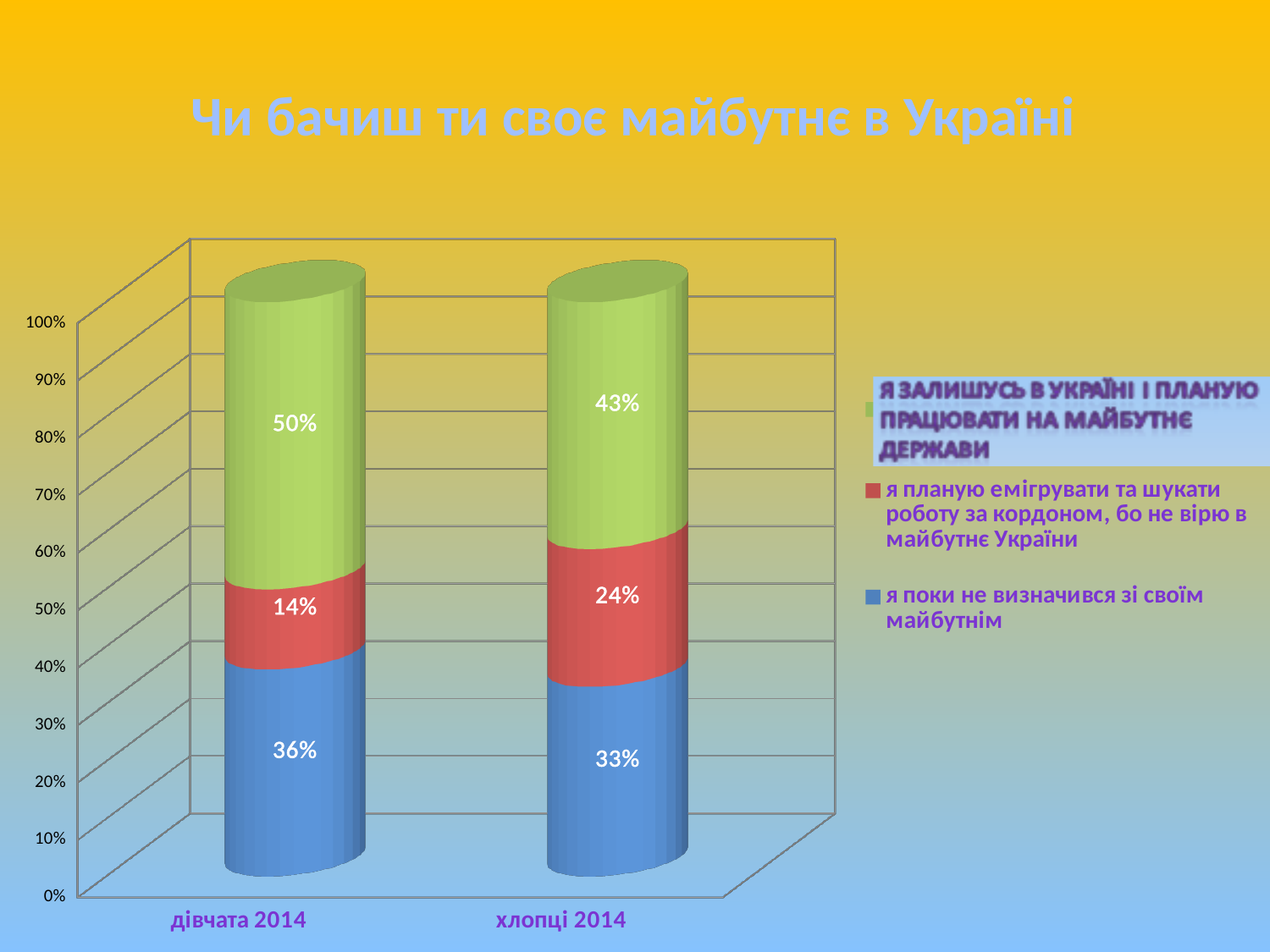
Which group has the larger share for "я залишусь в Україні і планую працювати на майбутнє держави", дівчата 2014 or хлопці 2014? дівчата 2014 Which response has the smallest share among дівчата 2014? я планую емігрувати та шукати роботу за кордоном, бо не вірю в майбутнє України How many series does the chart's legend list? 3 What percentage of хлопці 2014 chose "я поки не визначився зі своїм майбутнім"? 33% What is the difference between the "я планую емігрувати" share for хлопці 2014 and for дівчата 2014? 10% What percentage of дівчата 2014 chose "я планую емігрувати та шукати роботу за кордоном, бо не вірю в майбутнє України"? 14% What percentage of хлопці 2014 chose "я планую емігрувати та шукати роботу за кордоном, бо не вірю в майбутнє України"? 24% How many categories are shown on the x axis of the chart? 2 What percentage of дівчата 2014 chose "я залишусь в Україні і планую працювати на майбутнє держави"? 50% What is the difference between the "я поки не визначився зі своїм майбутнім" share for дівчата 2014 and for хлопці 2014? 3% What type of chart is shown on the slide? Stacked bar chart Which response has the largest share among хлопці 2014? я залишусь в Україні і планую працювати на майбутнє держави